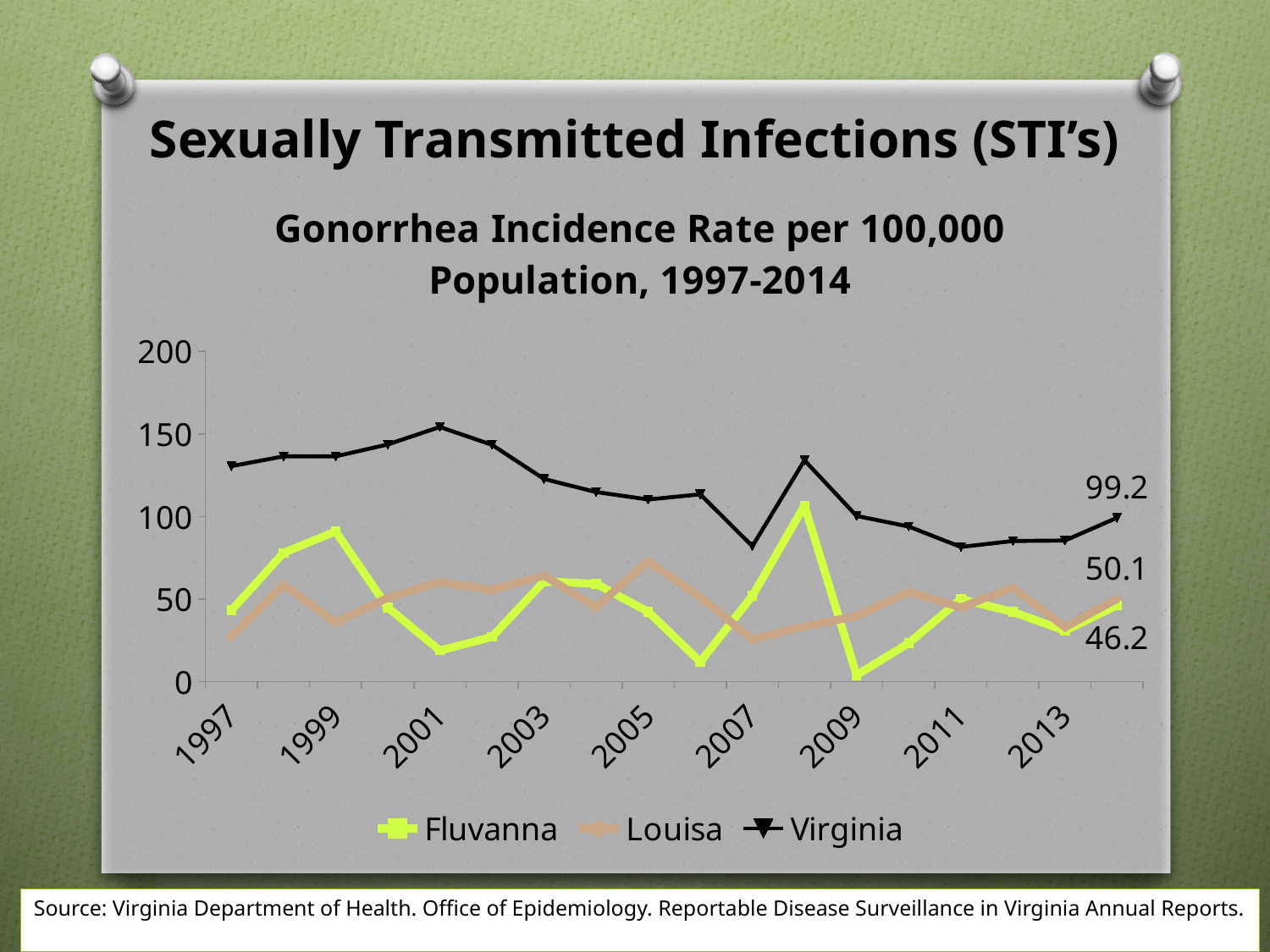
In 2014, how much higher is Virginia's rate than Fluvanna's rate? 53.0 Is the value for Virginia in 1997 greater or less than 100? greater What is the gonorrhea incidence rate for Fluvanna in 2014? 46.2 In 2014, what is the difference between Louisa's rate and Fluvanna's rate? 3.9 What is the gonorrhea incidence rate for Louisa in 2014? 50.1 Is the value for Fluvanna in 2009 greater or less than 50? less What is the gonorrhea incidence rate for Virginia in 2014? 99.2 In 2014, which is larger: the rate for Louisa or the rate for Fluvanna? Louisa What kind of chart is shown on the slide? Line chart Which series has the highest value in 2014? Virginia Does the Virginia line rise or fall from 2001 to 2007? Fall How many series does the legend list? 3